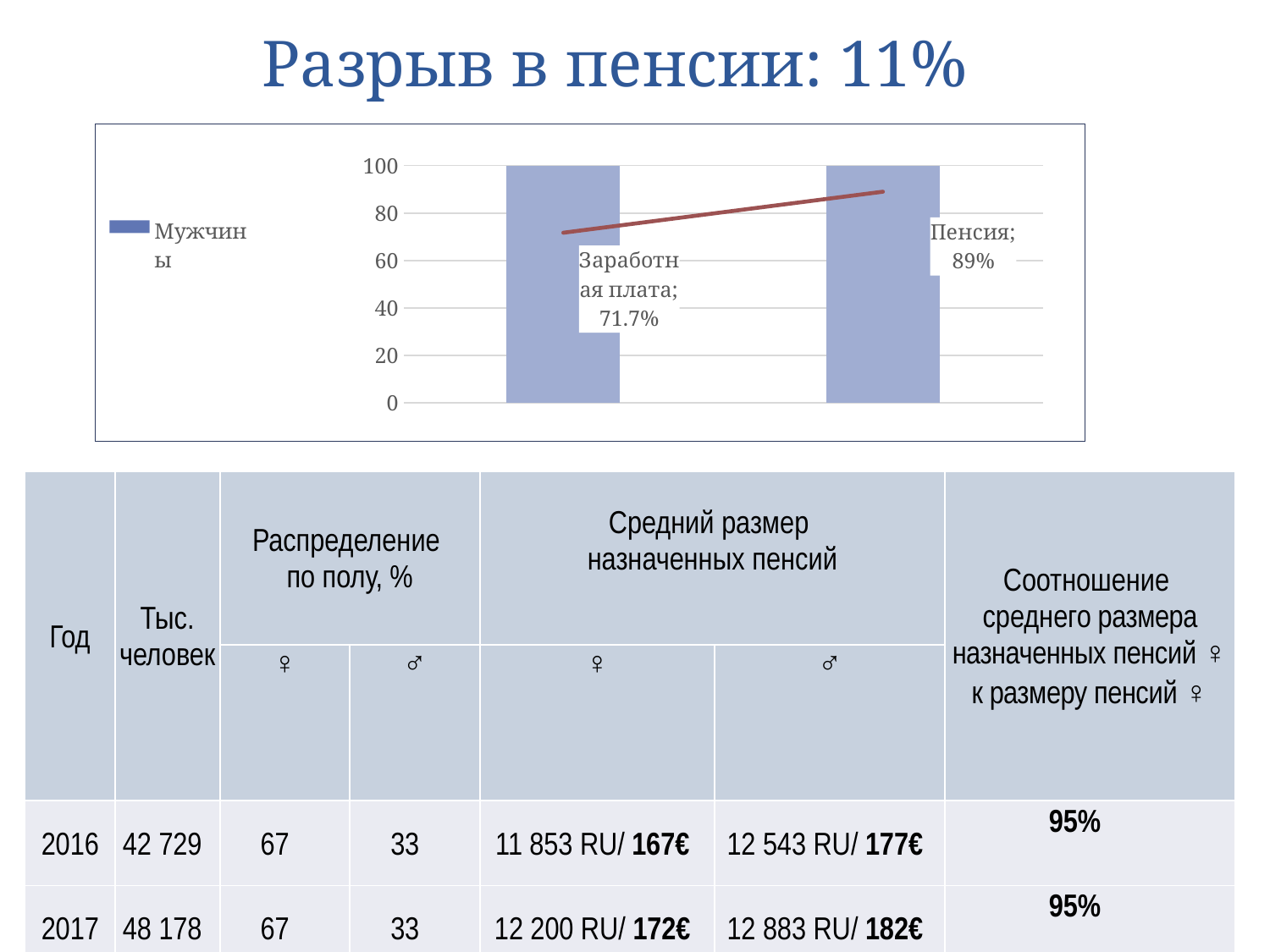
Does the line rise or fall from Заработная плата to Пенсия? rises What value is labelled on the line for the Пенсия category? 89% What value is labelled on the line for the Заработная плата category? 71.7% What is the difference between the labelled line values for Пенсия and Заработная плата? 17.3 percentage points Which category has the lowest labelled line value? Заработная плата What is the name of the series shown in the chart legend? Мужчины How many categories are shown on the x axis of the chart? 2 What value does the Мужчины bar reach for the Пенсия category? 100 Is the Мужчины bar for Заработная плата greater or less than 80? greater Which category has the higher labelled line value, Заработная плата or Пенсия? Пенсия How many series does the chart legend list? 1 What kind of chart is used for the Мужчины series? bar chart